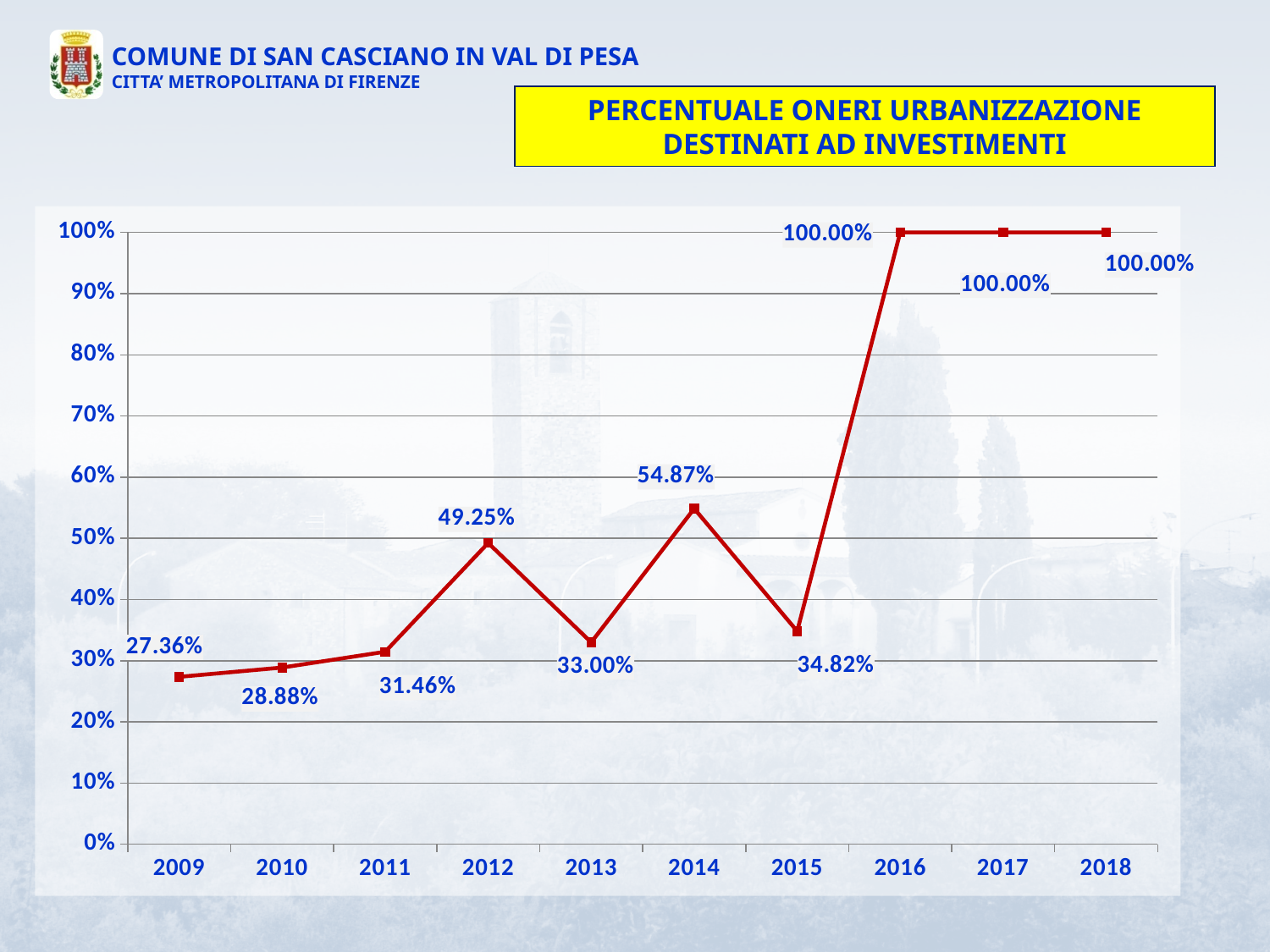
What is the value for 2015? 34.82% What is the title of the chart? PERCENTUALE ONERI URBANIZZAZIONE DESTINATI AD INVESTIMENTI What is the value for 2012? 49.25% Which year has the lowest value? 2009 What is the value for 2009? 27.36% Which is larger, the value for 2012 or the value for 2015? 2012 What type of chart is shown on the slide? Line chart What is the highest value shown on the chart? 100.00% What is the value for 2014? 54.87% What is the difference between the values for 2014 and 2013? 21.87% How many years are plotted on the x axis? 10 Does the value rise or fall from 2015 to 2016? Rise